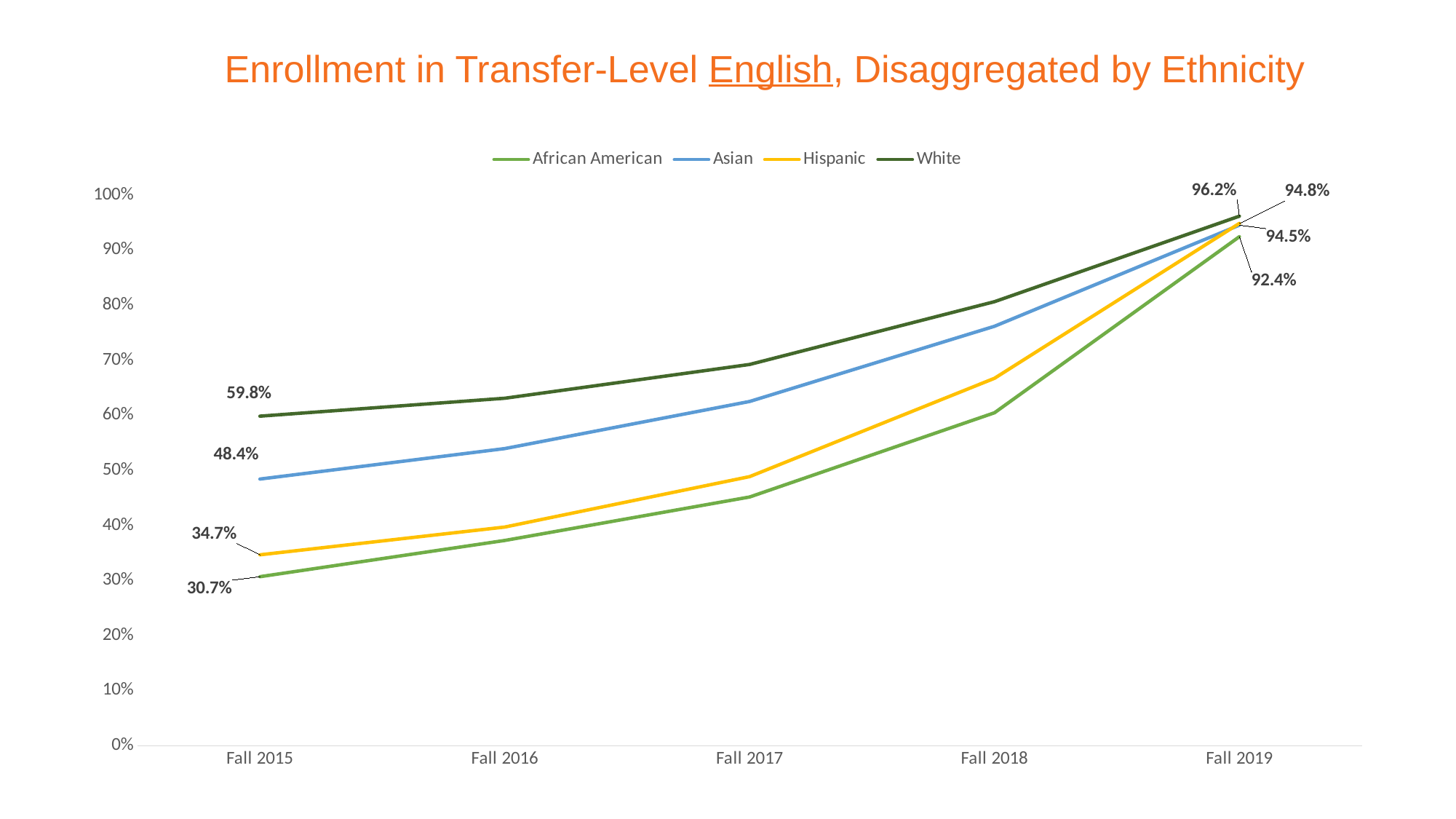
How many terms are shown on the x axis? 5 What was the enrollment rate for African American students in Fall 2019? 92.4% How many series does the legend list? 4 What was the enrollment rate for Asian students in Fall 2015? 48.4% By how many percentage points did the White enrollment rate increase from Fall 2015 to Fall 2019? 36.4 percentage points Which ethnic group had the lowest enrollment rate in Fall 2015? African American Which ethnic group had the highest enrollment rate in Fall 2015? White Is the value for Asian students in Fall 2018 greater or less than 70%? greater What was the enrollment rate for African American students in Fall 2015? 30.7% What was the enrollment rate for White students in Fall 2015? 59.8% What was the enrollment rate for Hispanic students in Fall 2015? 34.7% What was the enrollment rate for White students in Fall 2019? 96.2%